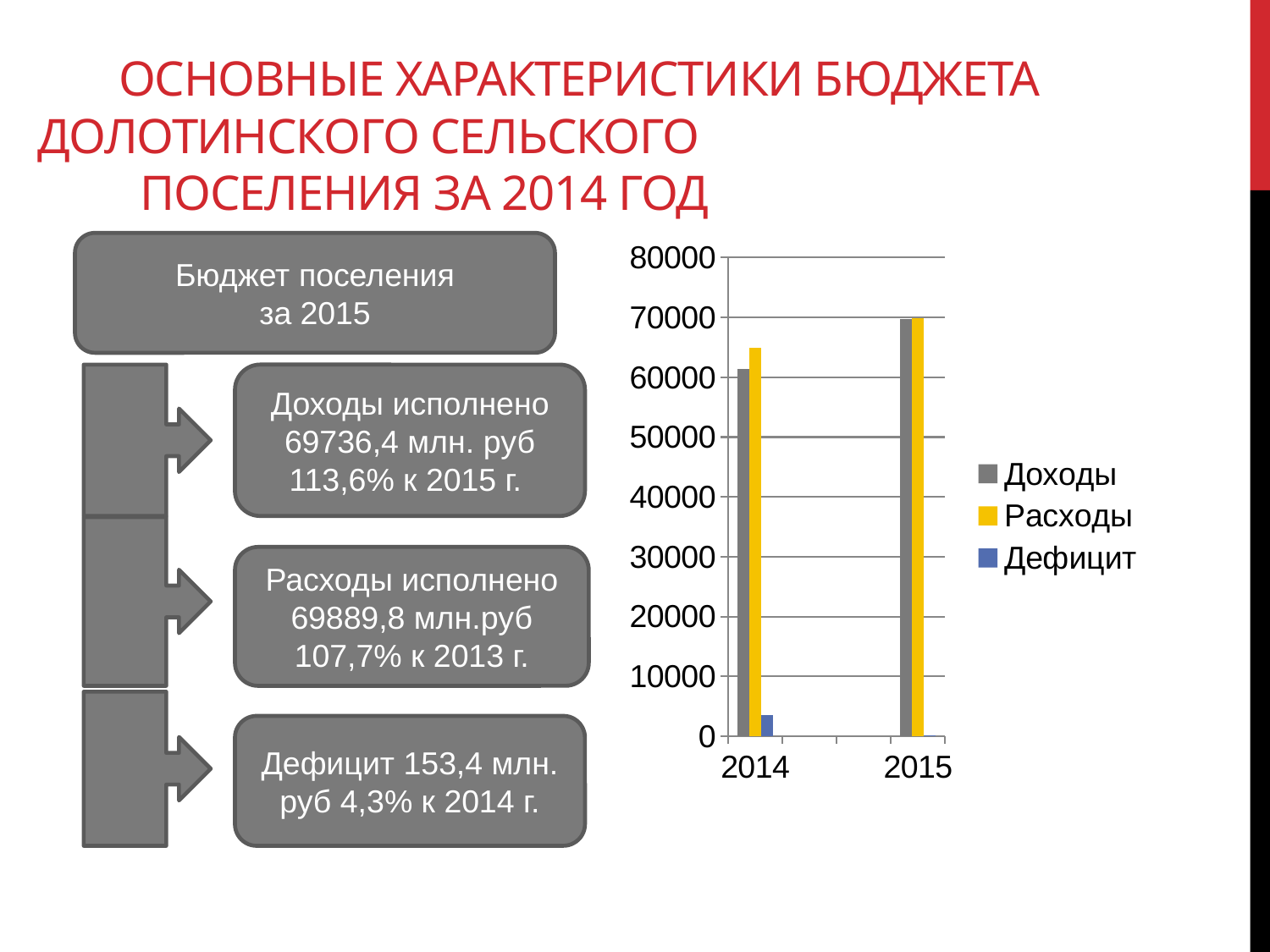
Is the value for Доходы in 2014 greater or less than 50000? greater Which series is shown in yellow in the chart? Расходы In which year is the value for Доходы highest? 2015 Is the value for Расходы in 2014 greater or less than 70000? less How many categories are shown on the x axis of the chart? 2 Is the value for Дефицит in 2014 greater or less than 10000? less Do the values for Расходы rise or fall from 2014 to 2015? rise What kind of chart is shown on the slide? bar chart How many series does the chart legend list? 3 In 2014, which is larger: Доходы or Расходы? Расходы Which years are shown on the x axis of the chart? 2014 and 2015